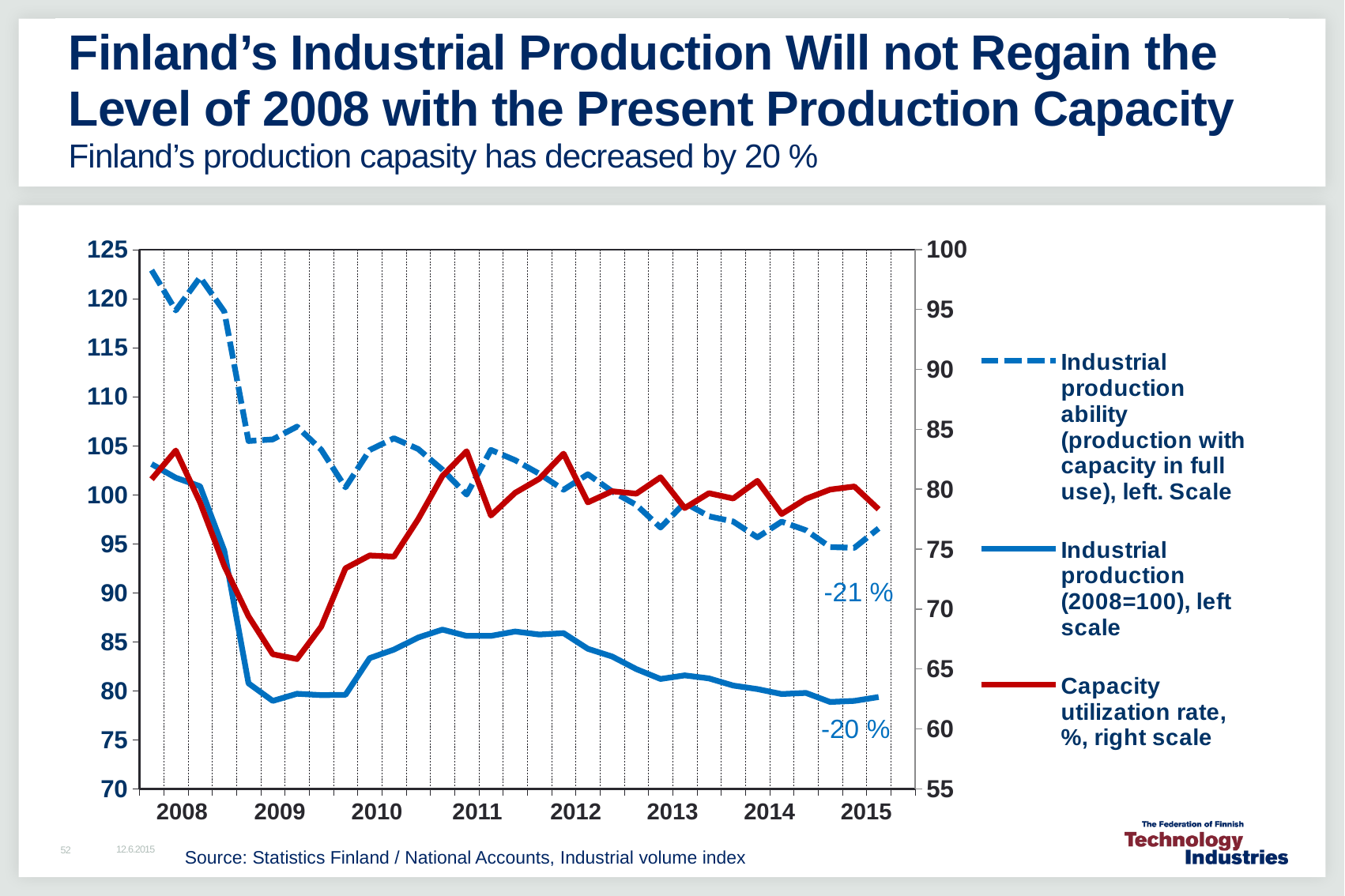
Does the Capacity utilization rate series rise or fall between 2009 and 2011? rise Does the Industrial production (2008=100) series rise or fall overall from 2008 to 2015? fall In 2015, which is higher: Industrial production ability or Industrial production (2008=100)? Industrial production ability How many years are labelled on the x axis? 8 Is the lowest value of the Capacity utilization rate in 2009 greater or less than 70 on the right scale? less How many series does the legend list? 3 What type of chart is shown on the slide? line chart Which series is plotted against the right scale? Capacity utilization rate, % What percentage change is annotated next to the end of the Industrial production (2008=100) line? -20 % Is the value of Industrial production ability at the start of 2008 greater or less than 120? greater In which year does the Industrial production ability series reach its highest value? 2008 Is the value of Industrial production (2008=100) in 2015 greater or less than 85? less